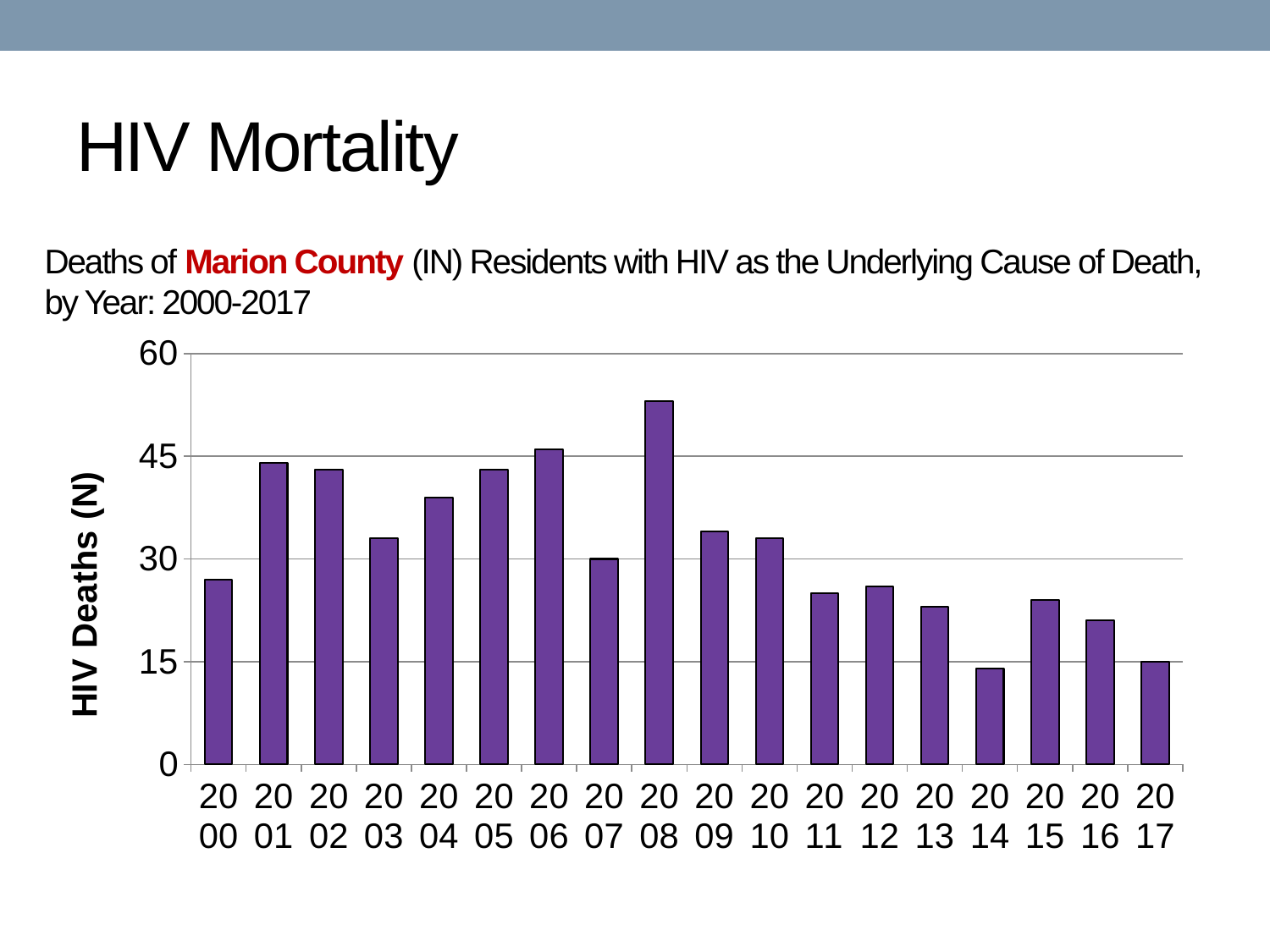
Which year has more HIV deaths, 2001 or 2011? 2001 Which year has more HIV deaths, 2013 or 2016? 2013 What is the label on the y axis? HIV Deaths (N) Is the value for 2008 greater or less than 45? greater What kind of chart is shown on the slide? bar chart Which year has the highest number of HIV deaths? 2008 How many years are plotted on the x axis? 18 Do HIV deaths generally rise or fall from 2008 to 2017? fall Is the value for 2000 greater or less than 30? less Which year has the lowest number of HIV deaths? 2014